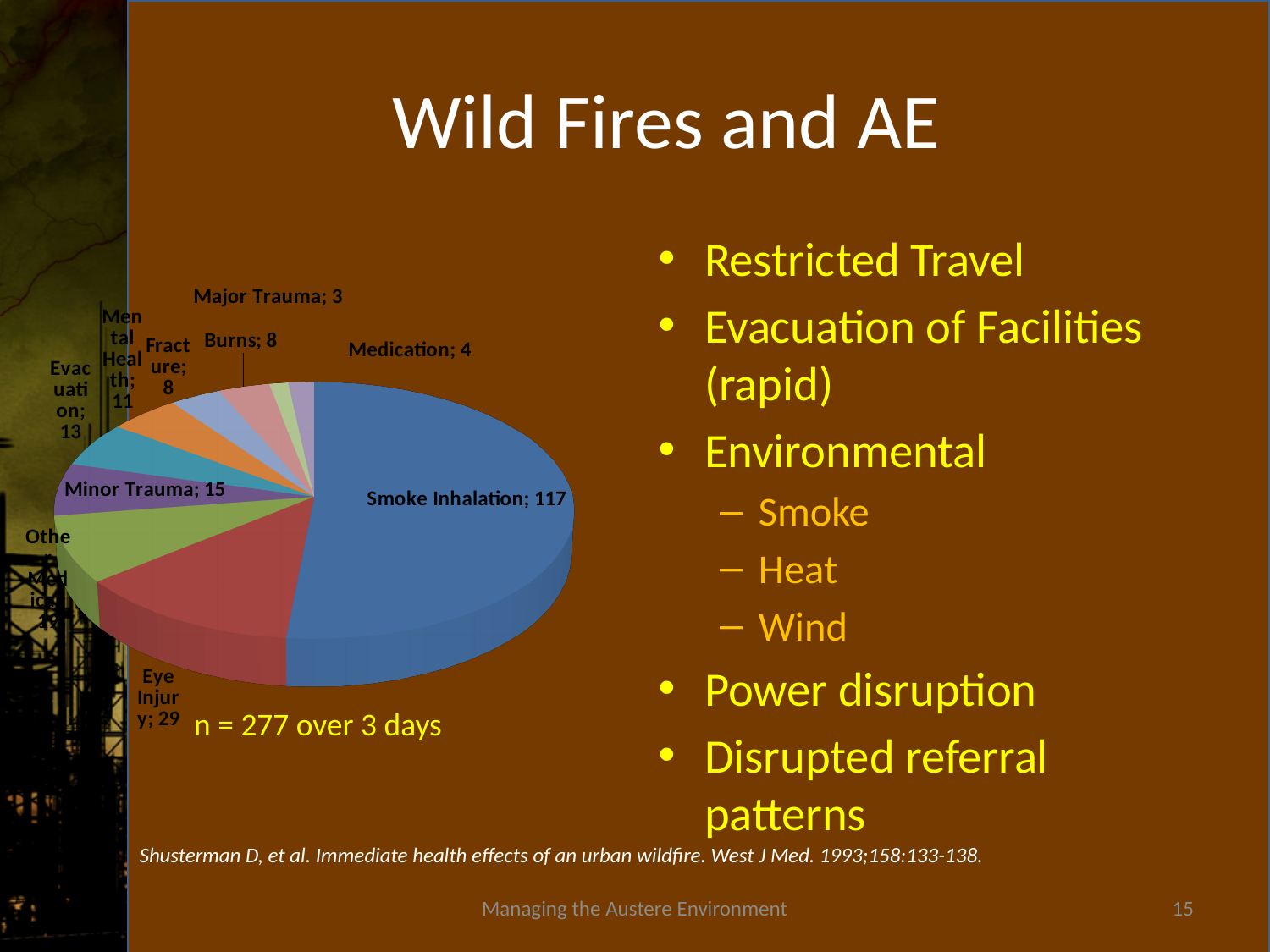
What kind of chart is shown on the slide? Pie chart What is the value for Major Trauma in the pie chart? 3 What is the difference between the values for Smoke Inhalation and Eye Injury? 88 What is the value for Burns in the pie chart? 8 What is the value for Evacuation in the pie chart? 13 What is the value for Smoke Inhalation in the pie chart? 117 What is the value for Mental Health in the pie chart? 11 What is the value for Minor Trauma in the pie chart? 15 Which category has the largest slice in the pie chart? Smoke Inhalation Which category has the smallest slice in the pie chart? Major Trauma Which is larger, the value for Evacuation or the value for Mental Health? Evacuation What is the value for Eye Injury in the pie chart? 29